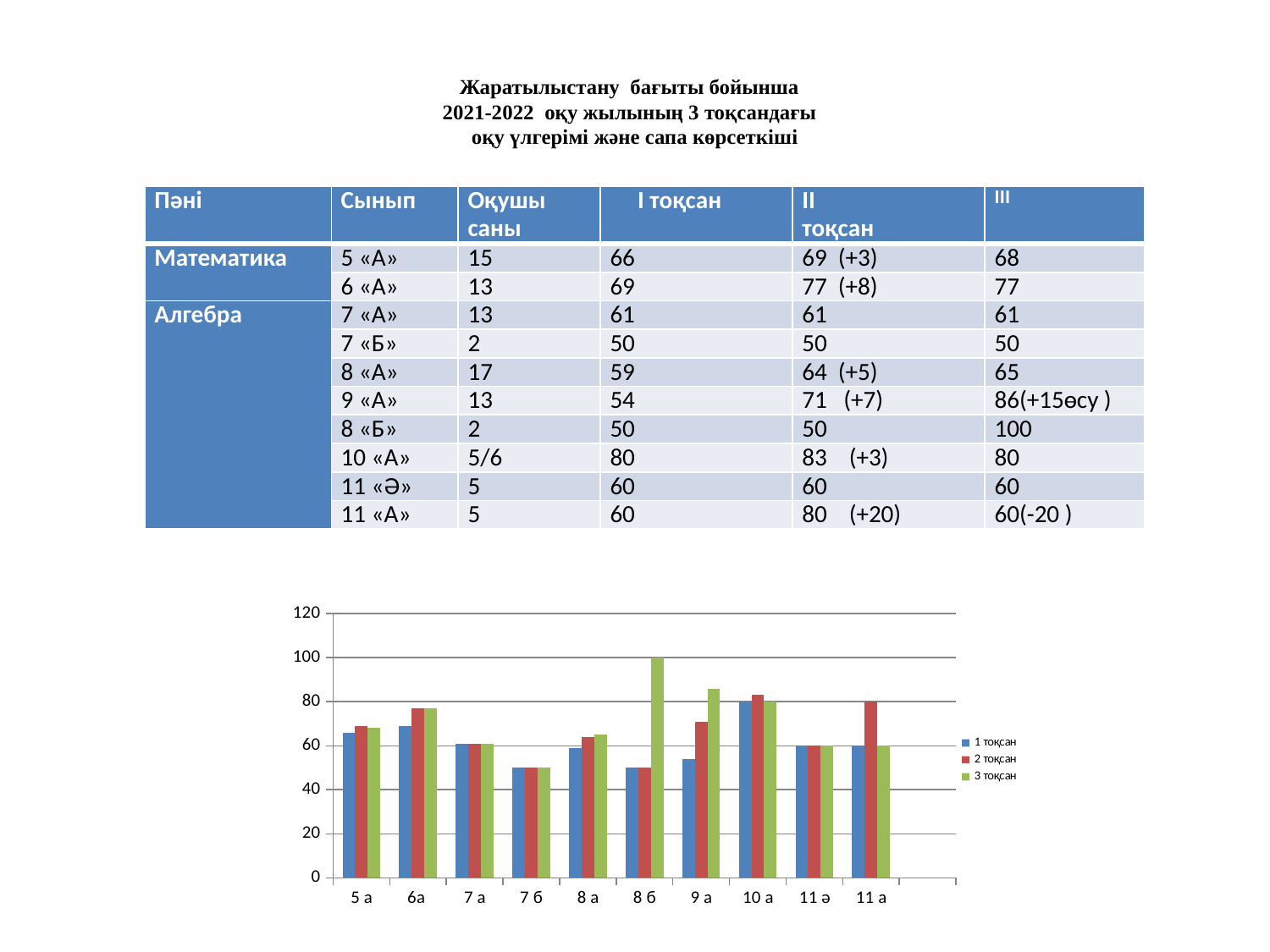
Which colour represents the 3 тоқсан series in the chart? green What is the value of the 3 тоқсан bar for 8 б in the chart? 100 For 11 а, which is larger: the 1 тоқсан bar or the 2 тоқсан bar? 2 тоқсан How many categories (classes) are shown along the x axis of the chart? 10 Which category has the tallest bar in the chart? 8 б Is the 3 тоқсан value for 9 а greater or less than 80? greater What is the value of the 1 тоқсан bar for 10 а in the chart? 80 What is the value of the 1 тоқсан bar for 11 ә in the chart? 60 What kind of chart is shown on the slide? bar chart Is the 1 тоқсан value for 9 а greater or less than 60? less How many series does the chart legend list? 3 Which category has the highest 1 тоқсан value in the chart? 10 а